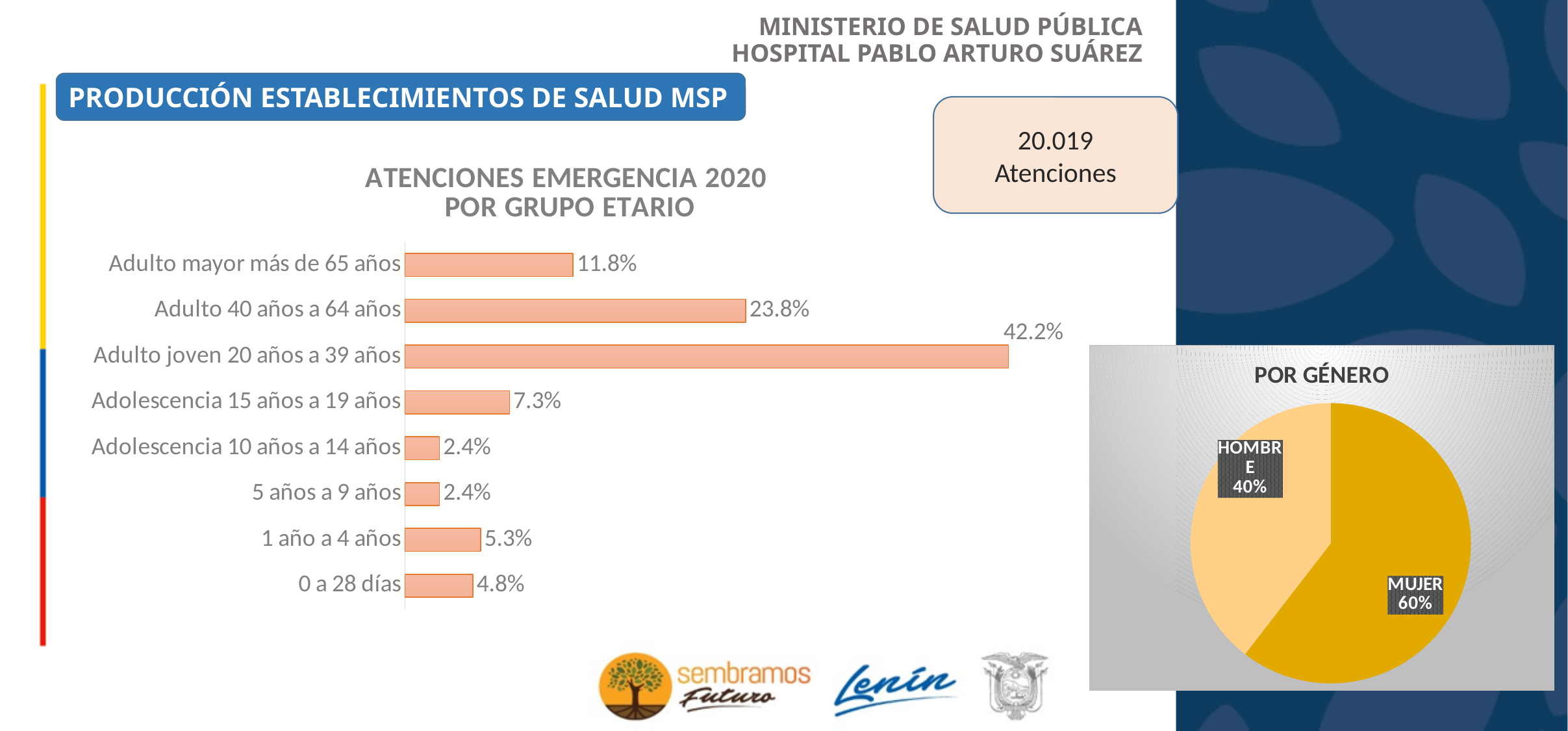
In the 'ATENCIONES EMERGENCIA 2020 POR GRUPO ETARIO' chart, what is the value for 'Adulto joven 20 años a 39 años'? 42.2% In the 'POR GÉNERO' chart, which slice is larger: 'MUJER' or 'HOMBRE'? MUJER What kind of chart is the 'POR GÉNERO' chart? Pie chart In the 'ATENCIONES EMERGENCIA 2020 POR GRUPO ETARIO' chart, which age group has the highest value? Adulto joven 20 años a 39 años In the 'POR GÉNERO' chart, what share is 'HOMBRE'? 40% How many age groups are shown in the 'ATENCIONES EMERGENCIA 2020 POR GRUPO ETARIO' chart? 8 In the 'POR GÉNERO' chart, what share is 'MUJER'? 60% What kind of chart is the 'ATENCIONES EMERGENCIA 2020 POR GRUPO ETARIO' chart? Bar chart In the 'ATENCIONES EMERGENCIA 2020 POR GRUPO ETARIO' chart, what is the value for '0 a 28 días'? 4.8% In the 'ATENCIONES EMERGENCIA 2020 POR GRUPO ETARIO' chart, what is the value for 'Adulto mayor más de 65 años'? 11.8% In the 'ATENCIONES EMERGENCIA 2020 POR GRUPO ETARIO' chart, which is larger: 'Adolescencia 15 años a 19 años' or '1 año a 4 años'? Adolescencia 15 años a 19 años In the 'ATENCIONES EMERGENCIA 2020 POR GRUPO ETARIO' chart, what is the difference between 'Adulto joven 20 años a 39 años' and 'Adulto 40 años a 64 años'? 18.4%